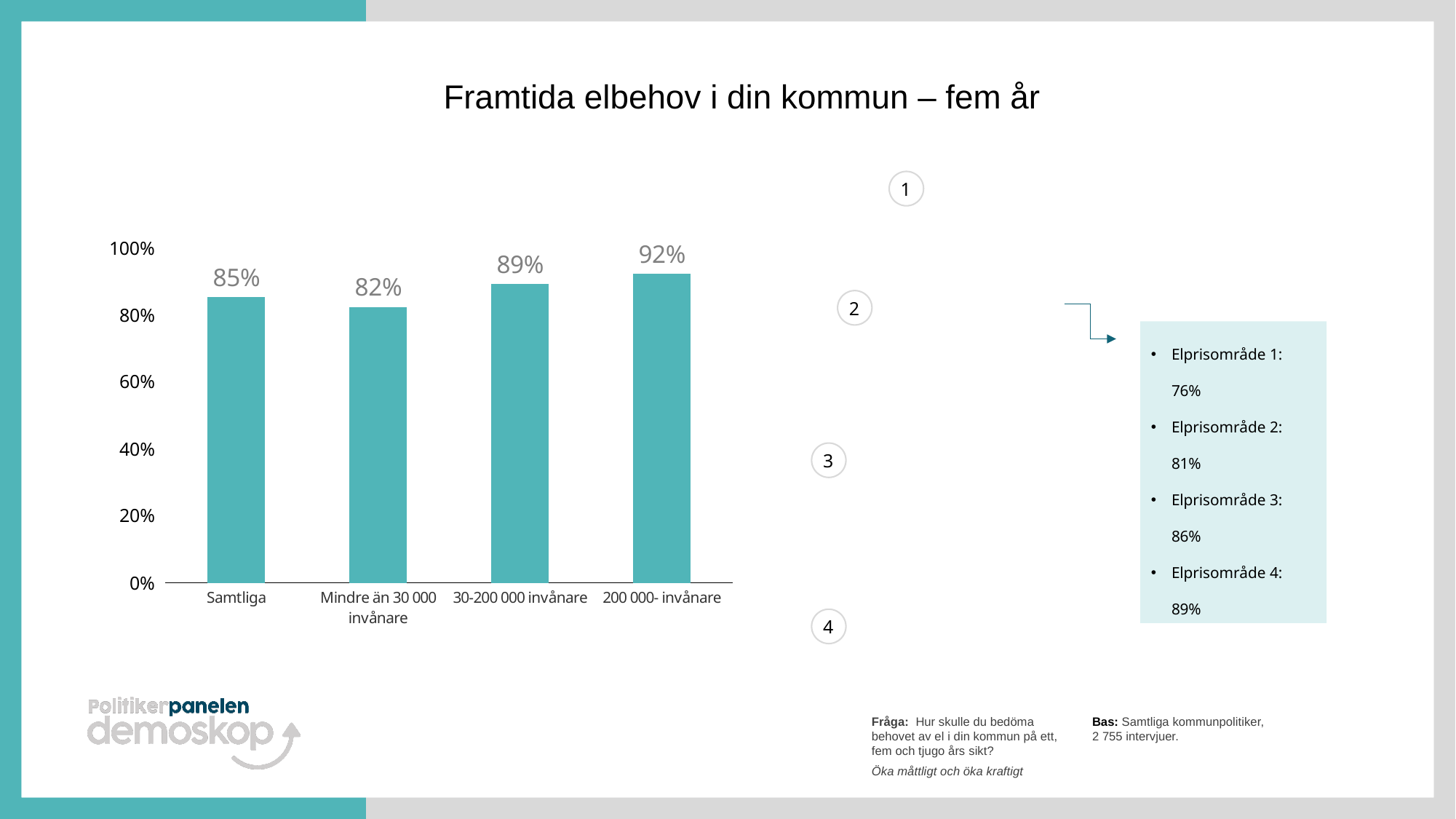
What is the value for Mindre än 30 000 invånare? 82% What is the value for 200 000- invånare? 92% Is the value for Mindre än 30 000 invånare greater or less than 80%? greater Which category has the highest value? 200 000- invånare What is the value for Samtliga? 85% What kind of chart is shown on the slide? bar chart What is the value for 30-200 000 invånare? 89% What is the title of the slide? Framtida elbehov i din kommun – fem år Which category has the lowest value? Mindre än 30 000 invånare What is the difference between the values for 200 000- invånare and Mindre än 30 000 invånare? 10% Which is larger, the value for Samtliga or the value for 30-200 000 invånare? 30-200 000 invånare How many categories are shown on the x axis? 4